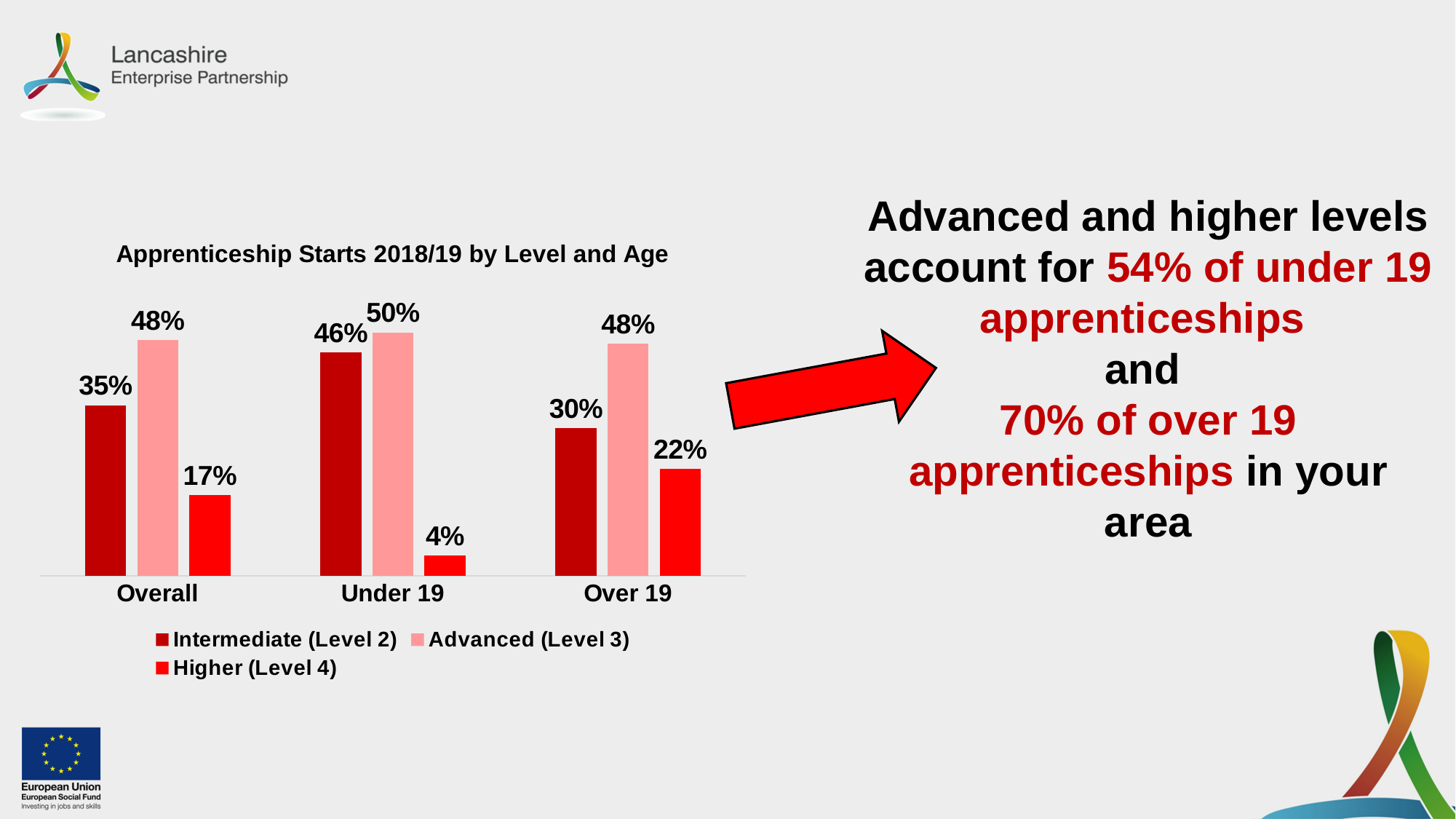
How many age categories are shown on the x axis? 3 Which is larger: Higher (Level 4) for Over 19 or Higher (Level 4) for Overall? Higher (Level 4) for Over 19 What is the value for Advanced (Level 3) in the Under 19 category? 50% What is the difference between the Intermediate (Level 2) values for Under 19 and Over 19? 16% What kind of chart is shown on the slide? Bar chart Which level has the highest value in the Over 19 category? Advanced (Level 3) What is the value for Higher (Level 4) in the Under 19 category? 4% What is the value for Intermediate (Level 2) in the Overall category? 35% Which level has the lowest value in the Under 19 category? Higher (Level 4) How many series does the legend list? 3 What is the value for Higher (Level 4) in the Over 19 category? 22% What is the title of the chart? Apprenticeship Starts 2018/19 by Level and Age